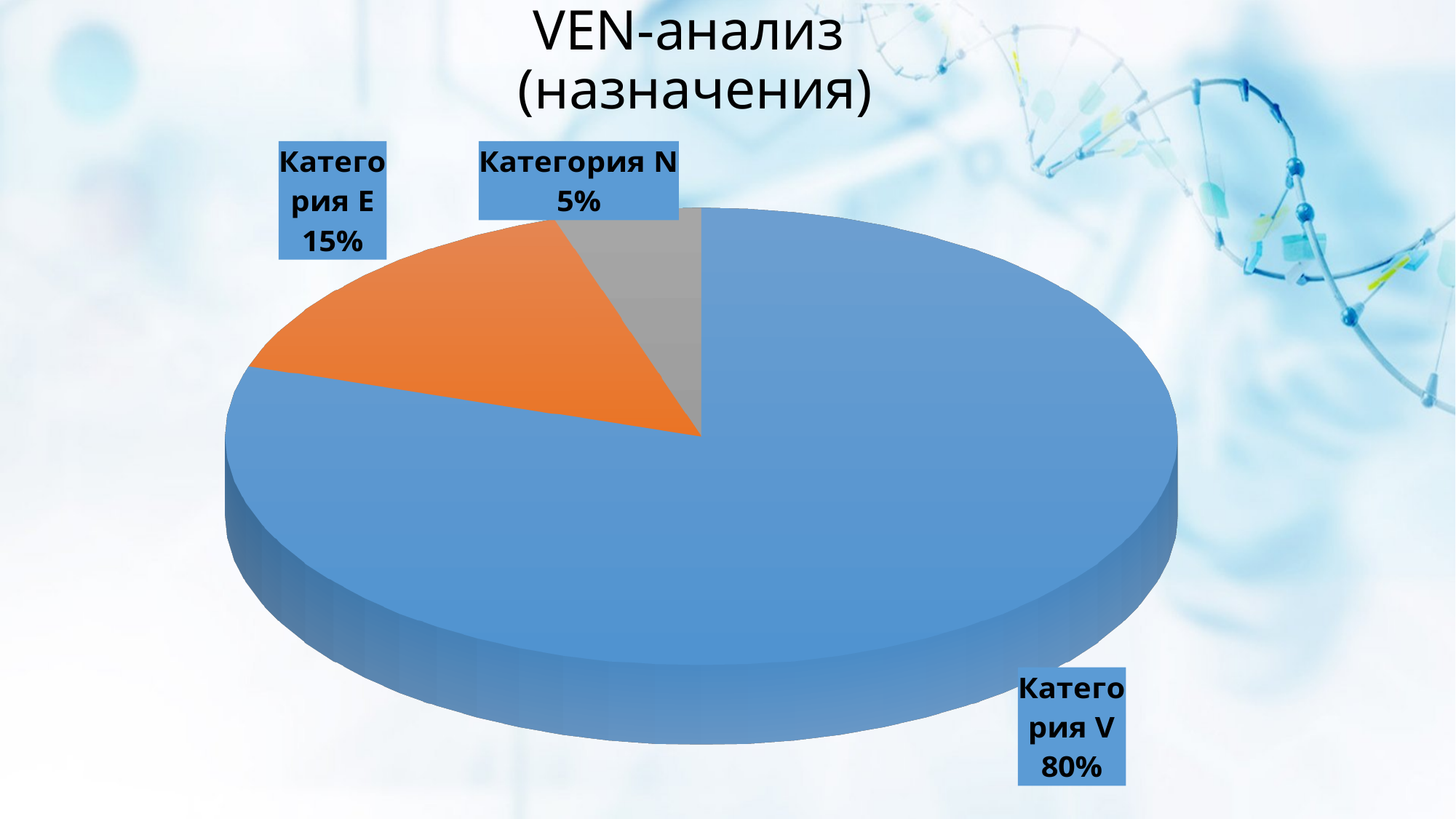
What share of the pie does Категория V have? 80% What is the title of the chart? VEN-анализ (назначения) What share of the pie does Категория N have? 5% What colour is the slice for Категория E? Orange What is the difference in percentage points between Категория E and Категория N? 10 Which category has the smallest slice of the pie? Категория N What is the difference in percentage points between Категория V and Категория E? 65 Which is larger, the share of Категория E or the share of Категория N? Категория E What kind of chart is shown on the slide? Pie chart Which category has the largest slice of the pie? Категория V How many categories are shown in the pie chart? 3 What share of the pie does Категория E have? 15%